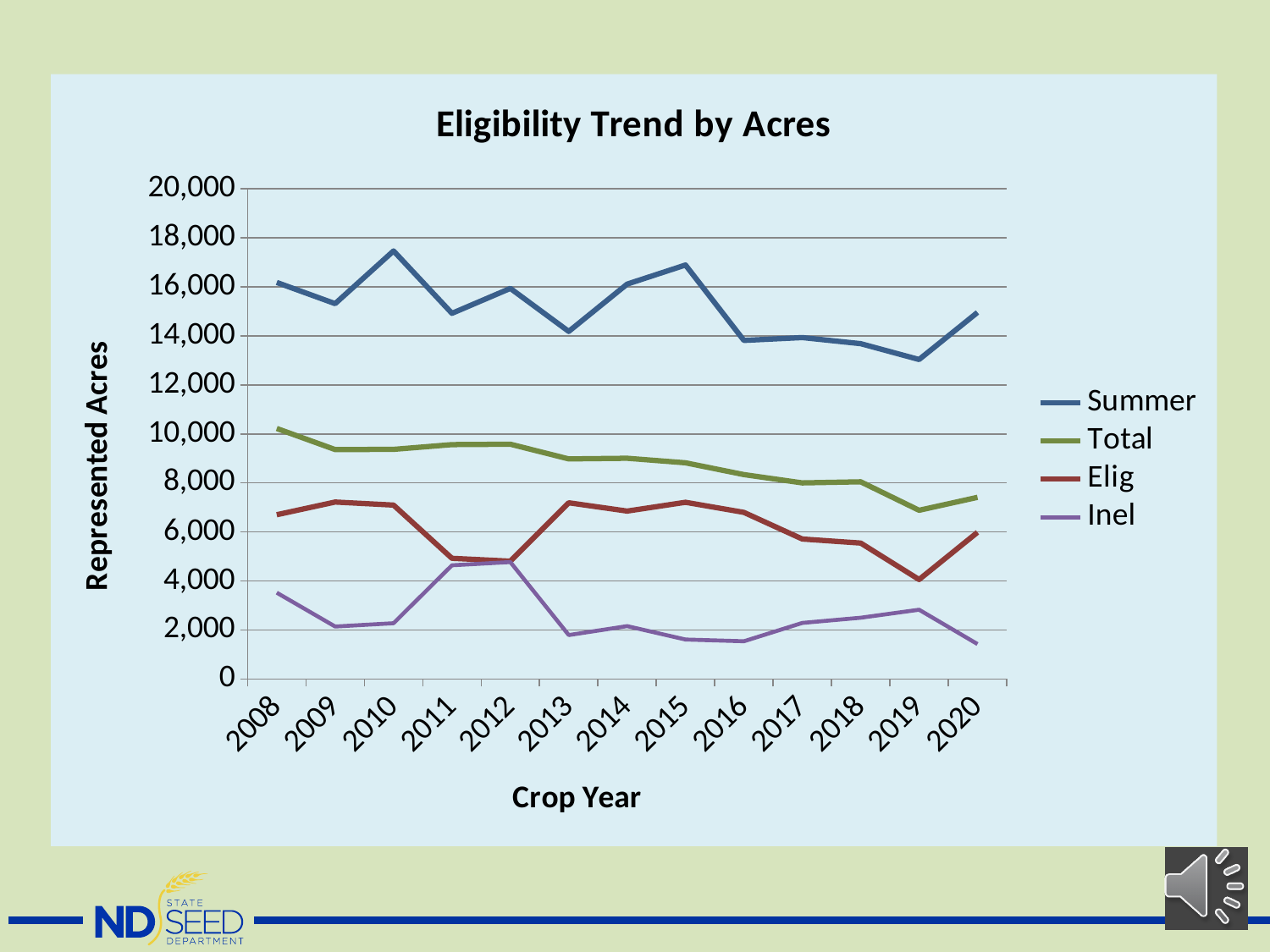
Does the Total series generally rise or fall from 2008 to 2020? fall Is the Summer value for 2010 greater or less than 16,000? greater In which crop year is the Summer series at its lowest? 2019 What is the title of the chart? Eligibility Trend by Acres In which crop year is the Summer series at its highest? 2010 How many crop years are plotted on the x axis? 13 In which crop year is the Elig series at its lowest? 2019 How many series does the legend list? 4 Is the Elig value for 2011 greater or less than 6,000? less In which crop year is the Total series at its highest? 2008 What kind of chart is shown on the slide? line chart Is the Total value for 2008 greater or less than 10,000? greater